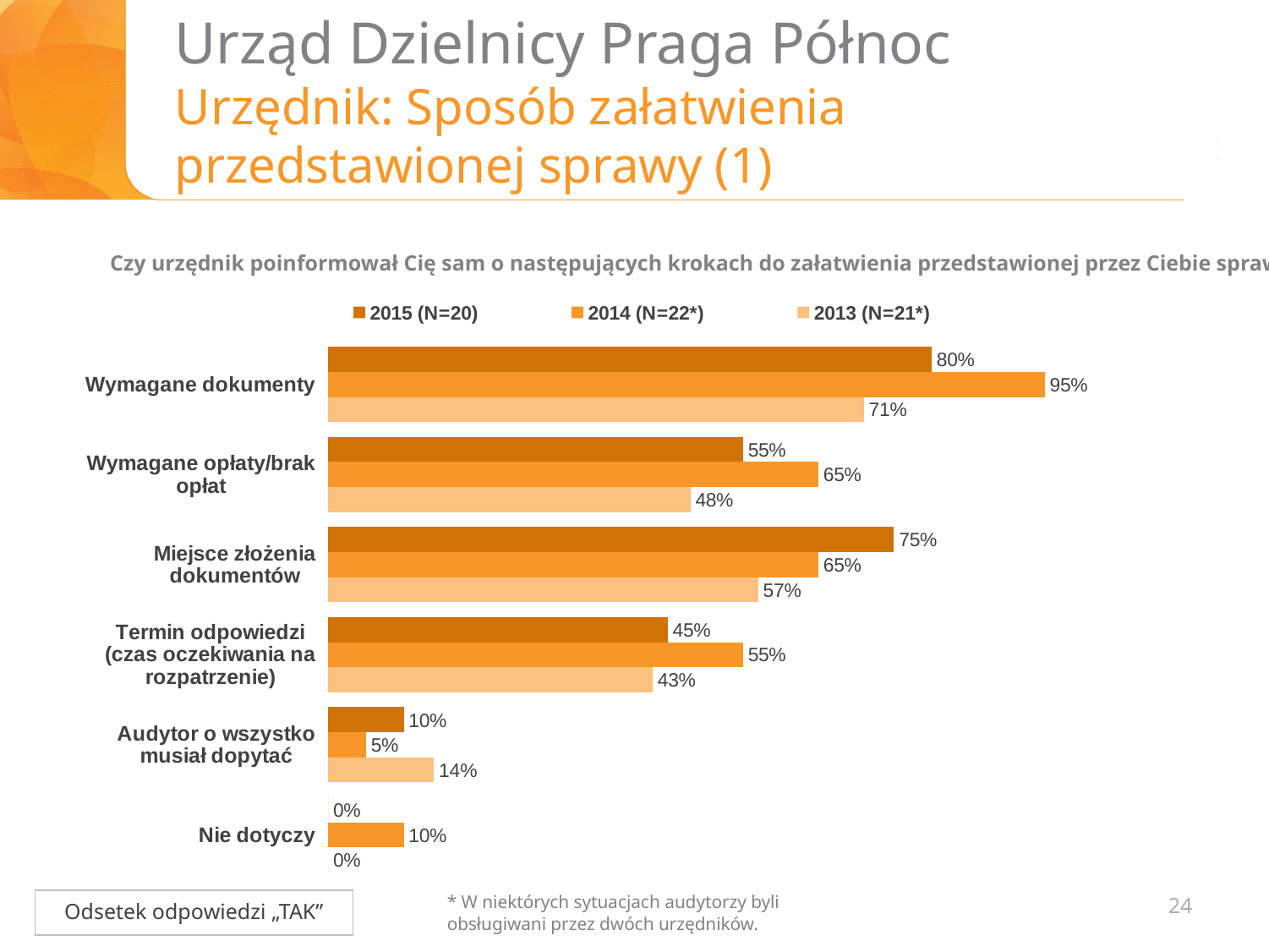
What is the value for "Audytor o wszystko musiał dopytać" in the 2013 (N=21*) series? 14% Which category has the lowest value in the 2014 (N=22*) series? Audytor o wszystko musiał dopytać What is the value for "Termin odpowiedzi (czas oczekiwania na rozpatrzenie)" in the 2015 (N=20) series? 45% What is the value for "Nie dotyczy" in the 2015 (N=20) series? 0% How many categories are shown on the chart? 6 Which category has the highest value in the 2015 (N=20) series? Wymagane dokumenty What kind of chart is shown on the slide? Bar chart Which is larger for "Miejsce złożenia dokumentów": the 2015 (N=20) value or the 2014 (N=22*) value? 2015 (N=20) How many series does the legend list? 3 What is the difference between the 2014 (N=22*) and 2013 (N=21*) values for "Wymagane dokumenty"? 24% Which series is shown in the lightest shade of orange in the legend? 2013 (N=21*) What is the value for "Wymagane dokumenty" in the 2014 (N=22*) series? 95%